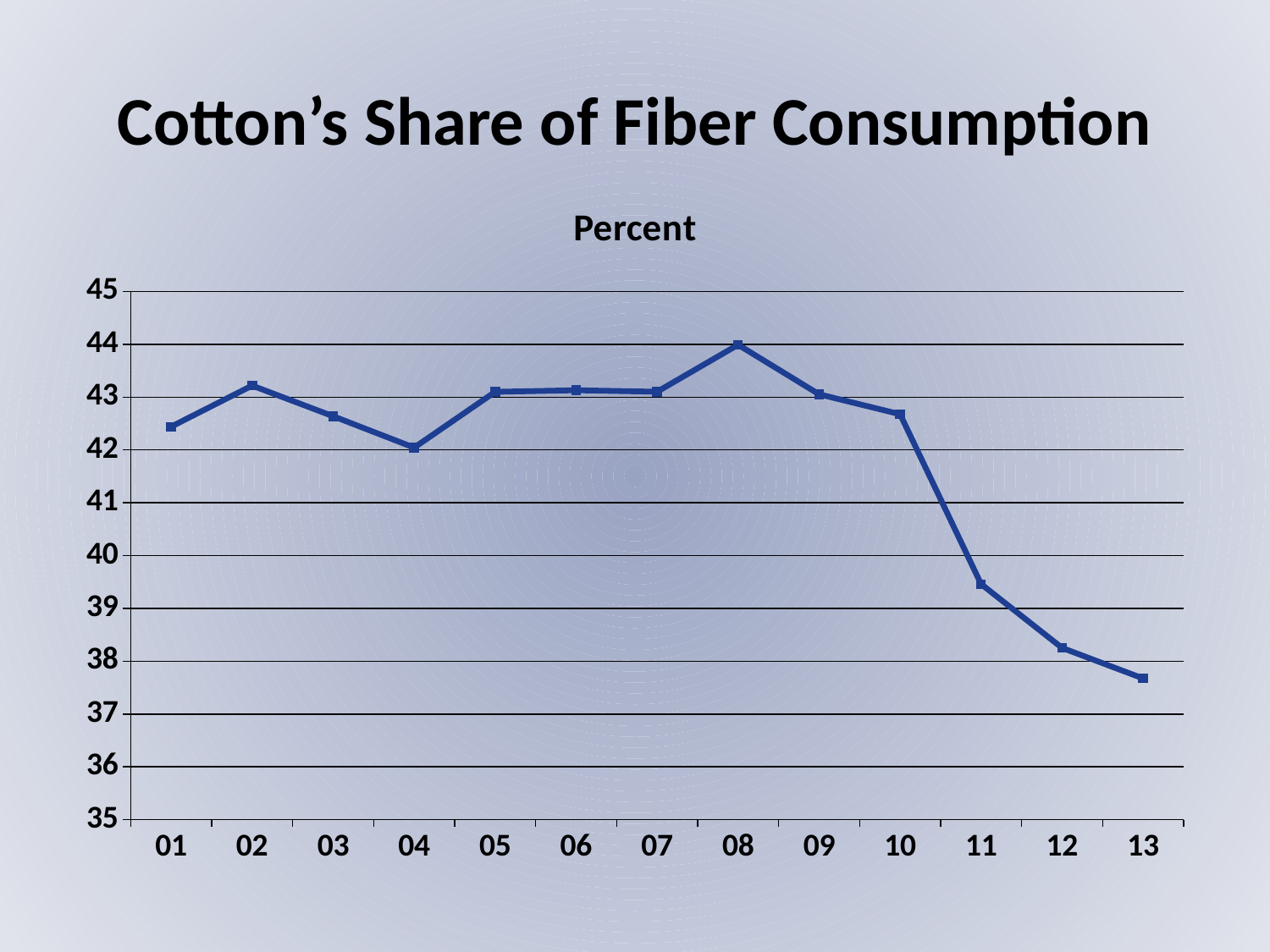
What is the title of the chart on the slide? Cotton's Share of Fiber Consumption What unit label appears above the chart's plot area? Percent What kind of chart is shown on the slide? line chart Is the value for 10 greater or less than 42? greater Do the values rise or fall from 10 to 13? fall Is the value for 13 greater or less than 38? less Which year has the larger value, 02 or 04? 02 How many years are plotted along the x axis? 13 Is the value for 11 greater or less than 40? less In which year is cotton's share of fiber consumption highest? 08 In which year is cotton's share of fiber consumption lowest? 13